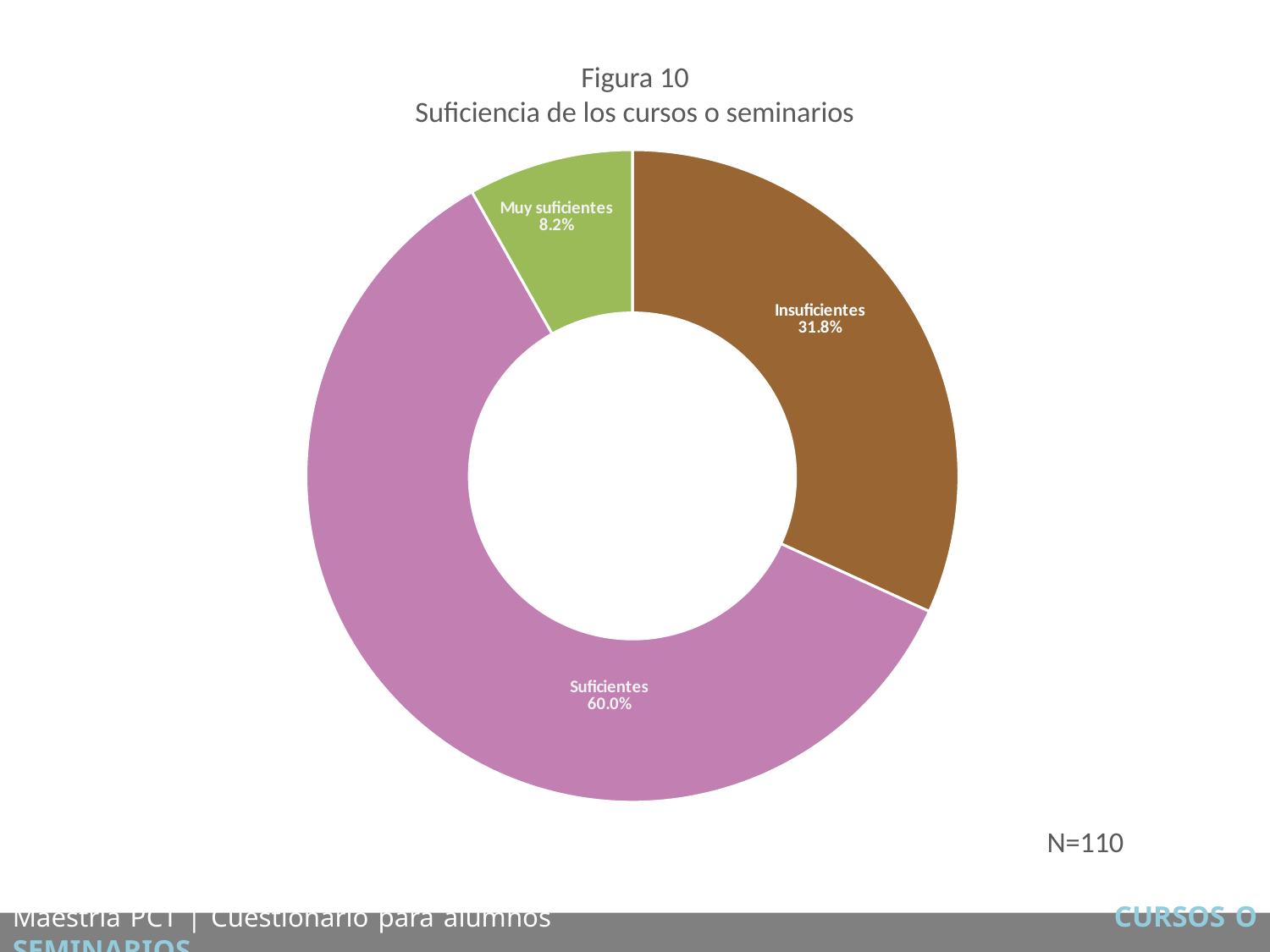
What sample size (N) is stated on the slide? N=110 What share of the pie does the Suficientes slice represent? 60.0% What is the difference in percentage points between Insuficientes and Muy suficientes? 23.6 Which category has the largest share? Suficientes What is the difference in percentage points between Suficientes and Insuficientes? 28.2 Which is larger, the share for Insuficientes or the share for Muy suficientes? Insuficientes What is the value shown for Muy suficientes? 8.2% What is the title of the chart? Figura 10 Suficiencia de los cursos o seminarios How many categories are shown in the chart? 3 What kind of chart is shown on the slide? Pie chart (doughnut) Which category has the smallest share? Muy suficientes What is the value shown for Insuficientes? 31.8%